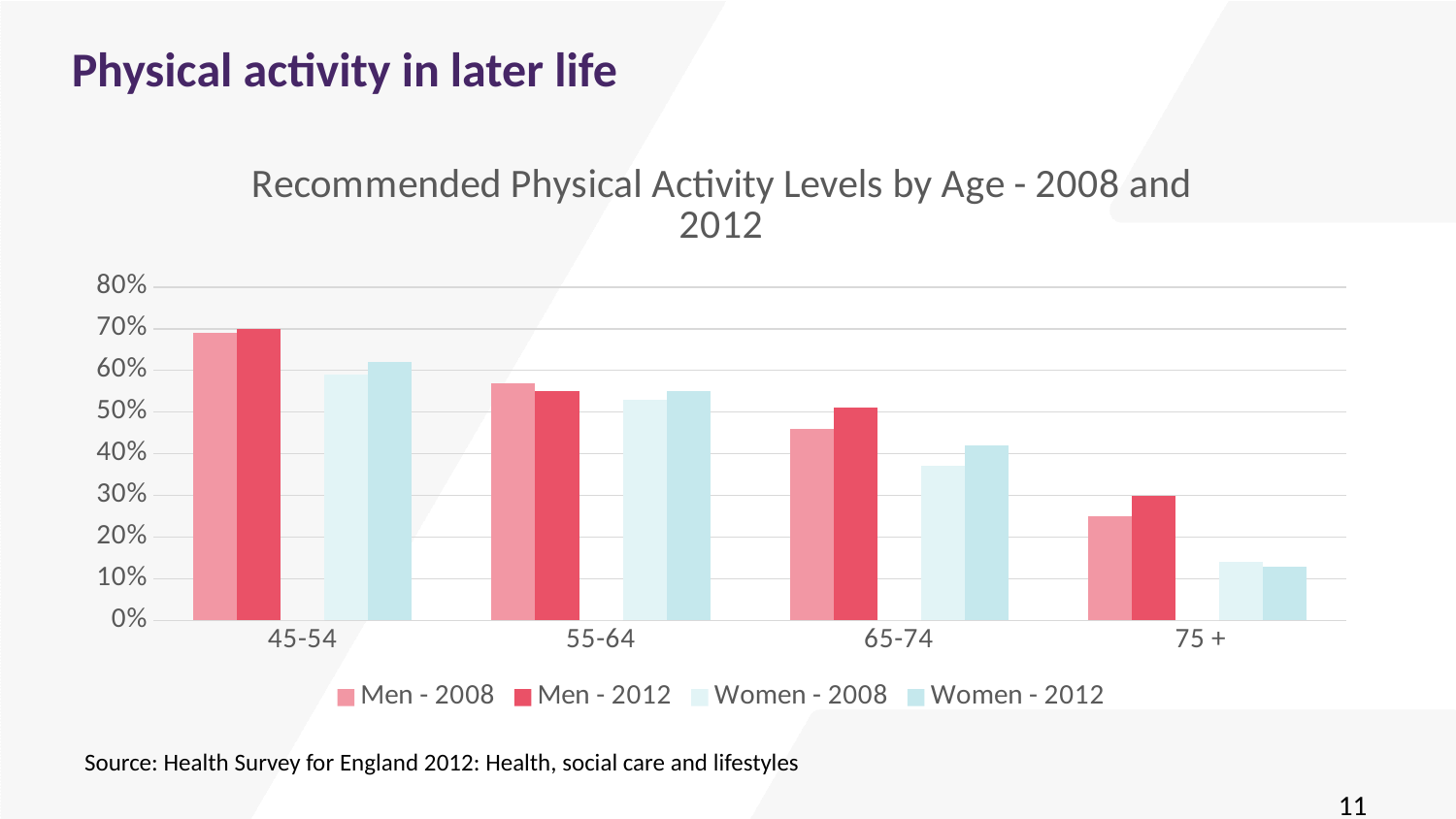
Is the value for Women - 2012 in the 75 + age group greater or less than 20%? less Is the value for Men - 2008 in the 45-54 age group greater or less than 60%? greater Which age group has the lowest value for Women - 2008? 75 + Is the value for Women - 2008 in the 65-74 age group greater or less than 40%? less In the 65-74 age group, which is larger: Men - 2012 or Women - 2012? Men - 2012 Which age group has the highest value for Men - 2008? 45-54 Do the Men - 2008 values rise or fall as age group increases along the x axis? Fall In the 65-74 age group, which is larger: Men - 2008 or Men - 2012? Men - 2012 How many age groups are shown on the x axis of the chart? 4 What is the title of the chart? Recommended Physical Activity Levels by Age - 2008 and 2012 How many series does the chart's legend list? 4 What kind of chart is shown on the slide? Bar chart